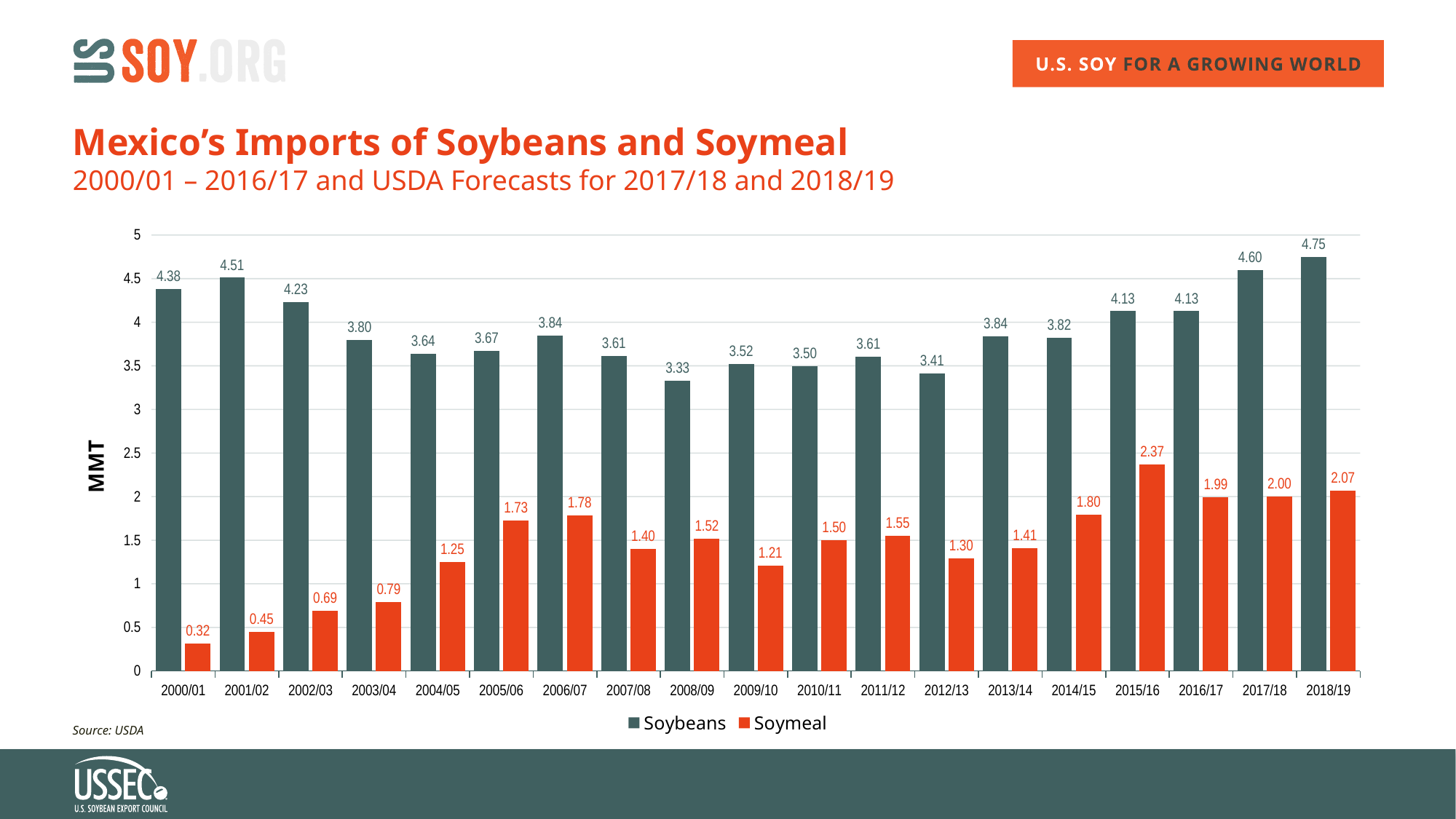
What is the value for Soybeans in 2000/01? 4.38 Which is larger, the Soymeal value in 2015/16 or in 2016/17? 2015/16 What is the value for Soymeal in 2015/16? 2.37 What is the label on the y axis? MMT How many years are shown on the x axis? 19 Which year has the highest Soybeans value? 2018/19 What kind of chart is shown on the slide? Bar chart How many series does the legend list? 2 What is the value for Soymeal in 2003/04? 0.79 Which year has the lowest Soymeal value? 2000/01 Which year has the lowest Soybeans value? 2008/09 What is the difference between the Soybeans and Soymeal values in 2018/19? 2.68